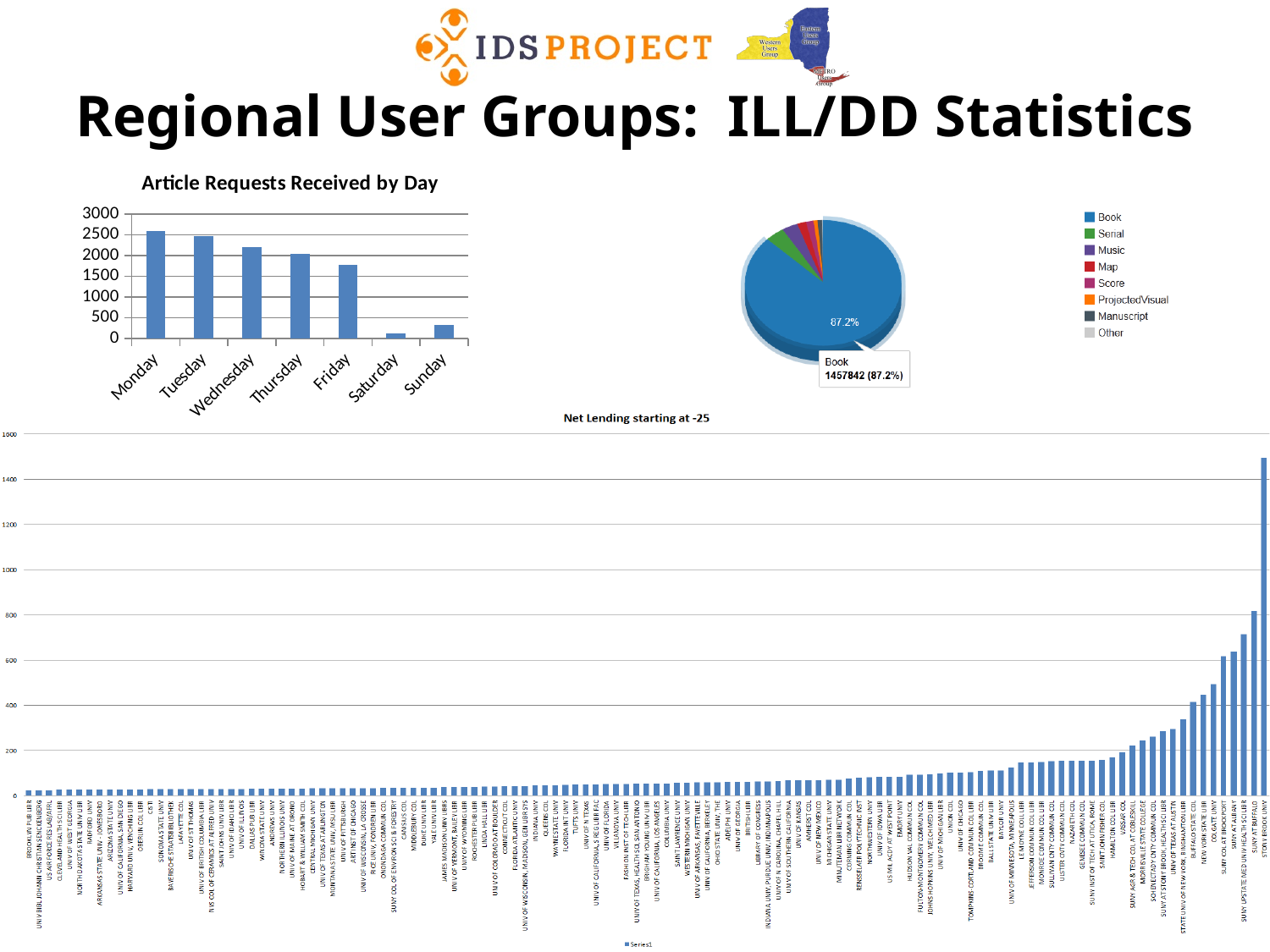
How many entries does the legend of the pie chart list? 8 In the pie chart, what share of the pie does the Book slice represent? 87.2% In the 'Article Requests Received by Day' chart, is the value for Sunday greater or less than 500? less In the 'Article Requests Received by Day' chart, is the value for Monday greater or less than 2500? greater In the 'Article Requests Received by Day' chart, do the values generally rise or fall from Monday to Friday? fall In the 'Article Requests Received by Day' chart, which has more article requests, Wednesday or Friday? Wednesday How many days (categories) are shown in the 'Article Requests Received by Day' chart? 7 In the 'Article Requests Received by Day' chart, is the value for Friday greater or less than 2000? less In the 'Article Requests Received by Day' chart, which day has the highest number of article requests? Monday In the pie chart, what is the value shown for Book? 1457842 What type of chart is 'Article Requests Received by Day'? bar chart In the 'Article Requests Received by Day' chart, which day has the lowest number of article requests? Saturday